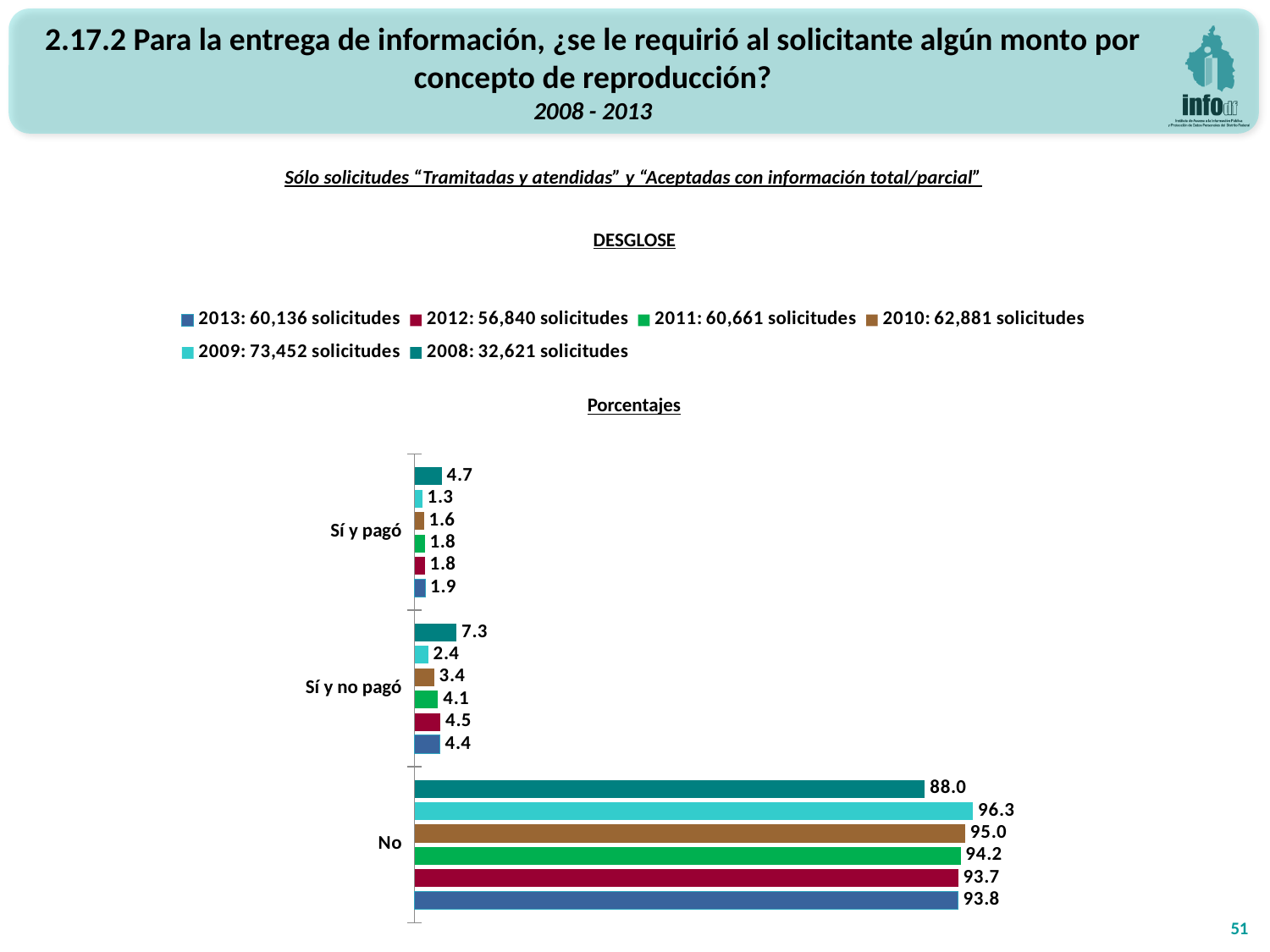
What is the value for "Sí y no pagó" in the 2013 series? 4.4 What is the value for "No" in the 2009 series? 96.3 How many series does the legend list? 6 According to the legend, how many solicitudes were there in 2009? 73,452 Which is larger for "Sí y no pagó": the 2008 value or the 2012 value? 2008 How many categories are shown on the chart? 3 What kind of chart is shown on the slide? Bar chart What is the value for "Sí y pagó" in the 2008 series? 4.7 What is the value for "Sí y no pagó" in the 2010 series? 3.4 Which year has the highest value for "No"? 2009 What is the difference between the 2009 and 2008 values for "No"? 8.3 Which year has the lowest value for "Sí y pagó"? 2009